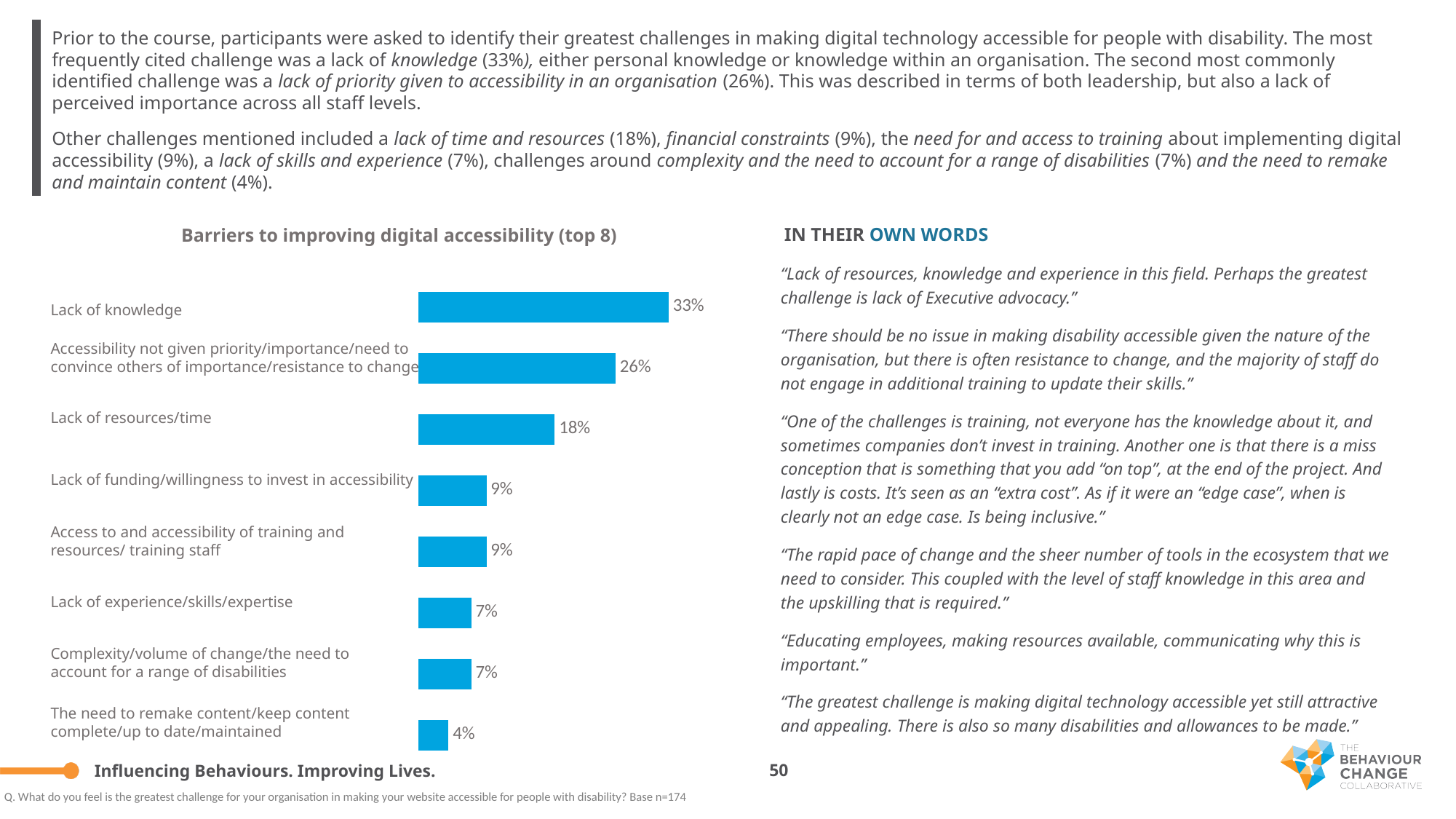
What is the difference between the values for Lack of resources/time and Lack of funding/willingness to invest in accessibility? 9% What is the value for Lack of knowledge? 33% How many categories are shown in the chart? 8 Which category has the lowest value? The need to remake content/keep content complete/up to date/maintained What is the title of the chart? Barriers to improving digital accessibility (top 8) What is the value for The need to remake content/keep content complete/up to date/maintained? 4% What is the value for Lack of resources/time? 18% What kind of chart is shown on the slide? Bar chart Which category has the highest value? Lack of knowledge What is the difference between the values for Lack of knowledge and Accessibility not given priority/importance/need to convince others of importance/resistance to change? 7% Which is larger: the value for Lack of resources/time or the value for Lack of experience/skills/expertise? Lack of resources/time What is the value for Lack of funding/willingness to invest in accessibility? 9%